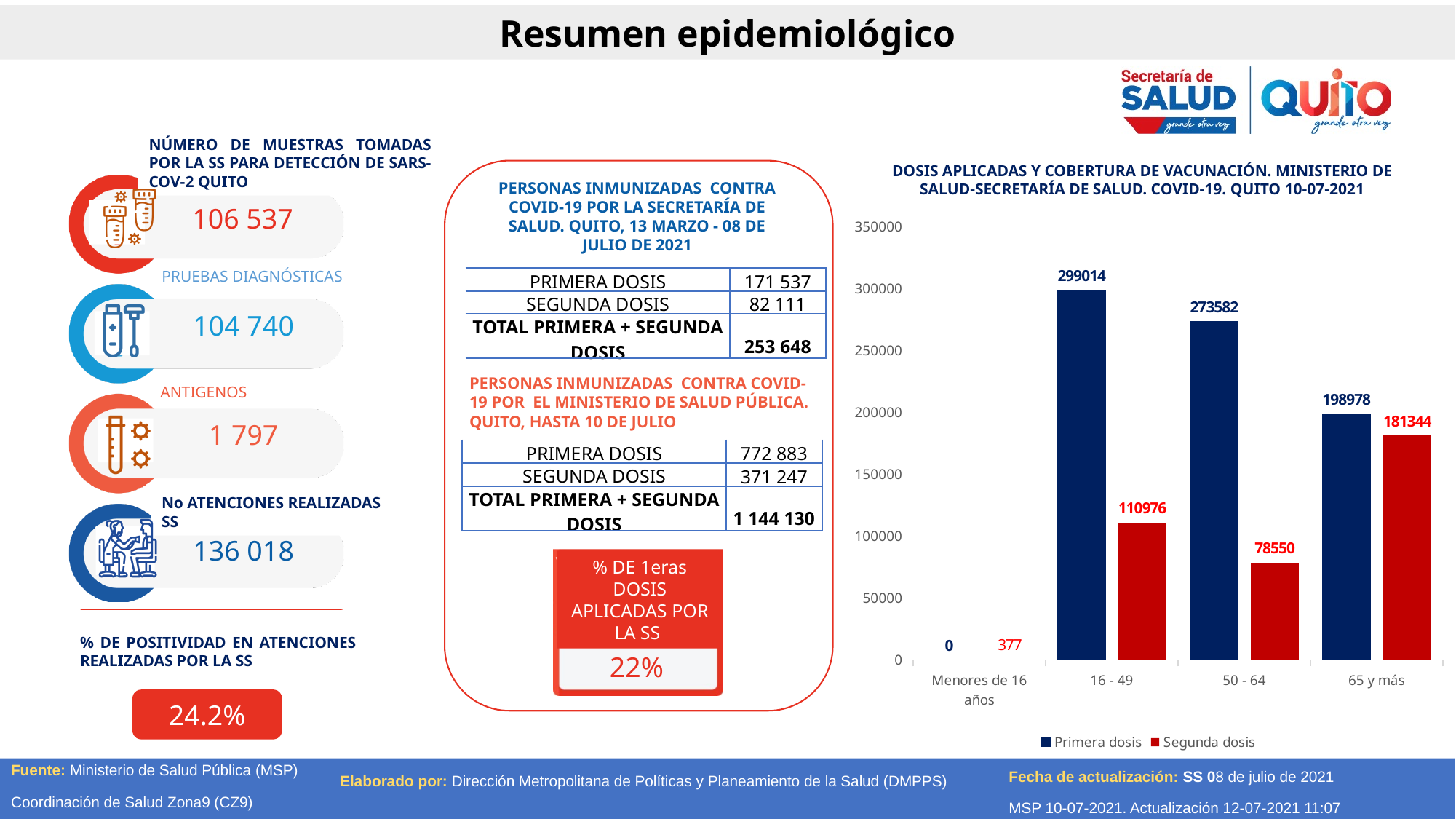
What is the value of Segunda dosis for the 65 y más age group? 181344 What is the value of Segunda dosis for the Menores de 16 años group? 377 What kind of chart is used to show the doses applied by age group? Bar chart What colour are the Segunda dosis bars in the chart? Red How many series does the chart legend list? 2 Which age group has the highest Primera dosis value? 16 - 49 Which age group has the lowest Segunda dosis value? Menores de 16 años Which is larger for the 65 y más group: Primera dosis or Segunda dosis? Primera dosis Is the Segunda dosis value for the 16 - 49 group greater or less than 100000? greater How many age groups are shown on the x axis of the chart? 4 What is the value of Primera dosis for the 16 - 49 age group? 299014 What is the difference between Primera dosis and Segunda dosis for the 50 - 64 age group? 195032